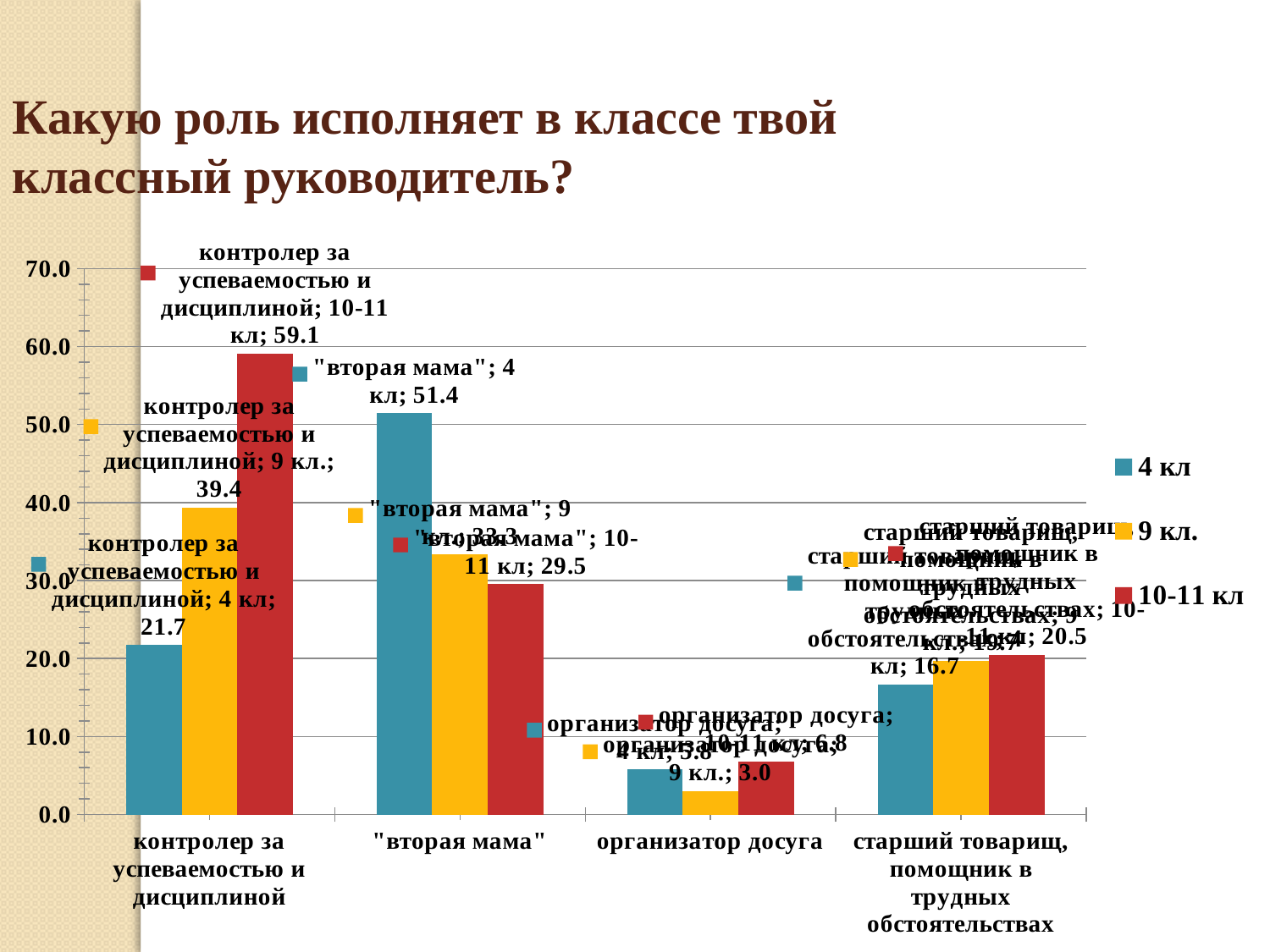
What is the value for 9 кл. in the category "организатор досуга"? 3.0 What is the value for 4 кл in the category "контролер за успеваемостью и дисциплиной"? 21.7 In the category "контролер за успеваемостью и дисциплиной", what is the difference between the 10-11 кл value and the 4 кл value? 37.4 What is the value for 9 кл. in the category "контролер за успеваемостью и дисциплиной"? 39.4 What is the value for 10-11 кл in the category "вторая мама"? 29.5 What is the value for 10-11 кл in the category "контролер за успеваемостью и дисциплиной"? 59.1 How many series does the legend list? 3 For the 10-11 кл series, which category has the highest value? контролер за успеваемостью и дисциплиной For the 4 кл series, which category has the lowest value? организатор досуга What kind of chart is shown on the slide? bar chart What is the value for 4 кл in the category "вторая мама"? 51.4 In the category "контролер за успеваемостью и дисциплиной", which is larger: the 9 кл. value or the 10-11 кл value? 10-11 кл